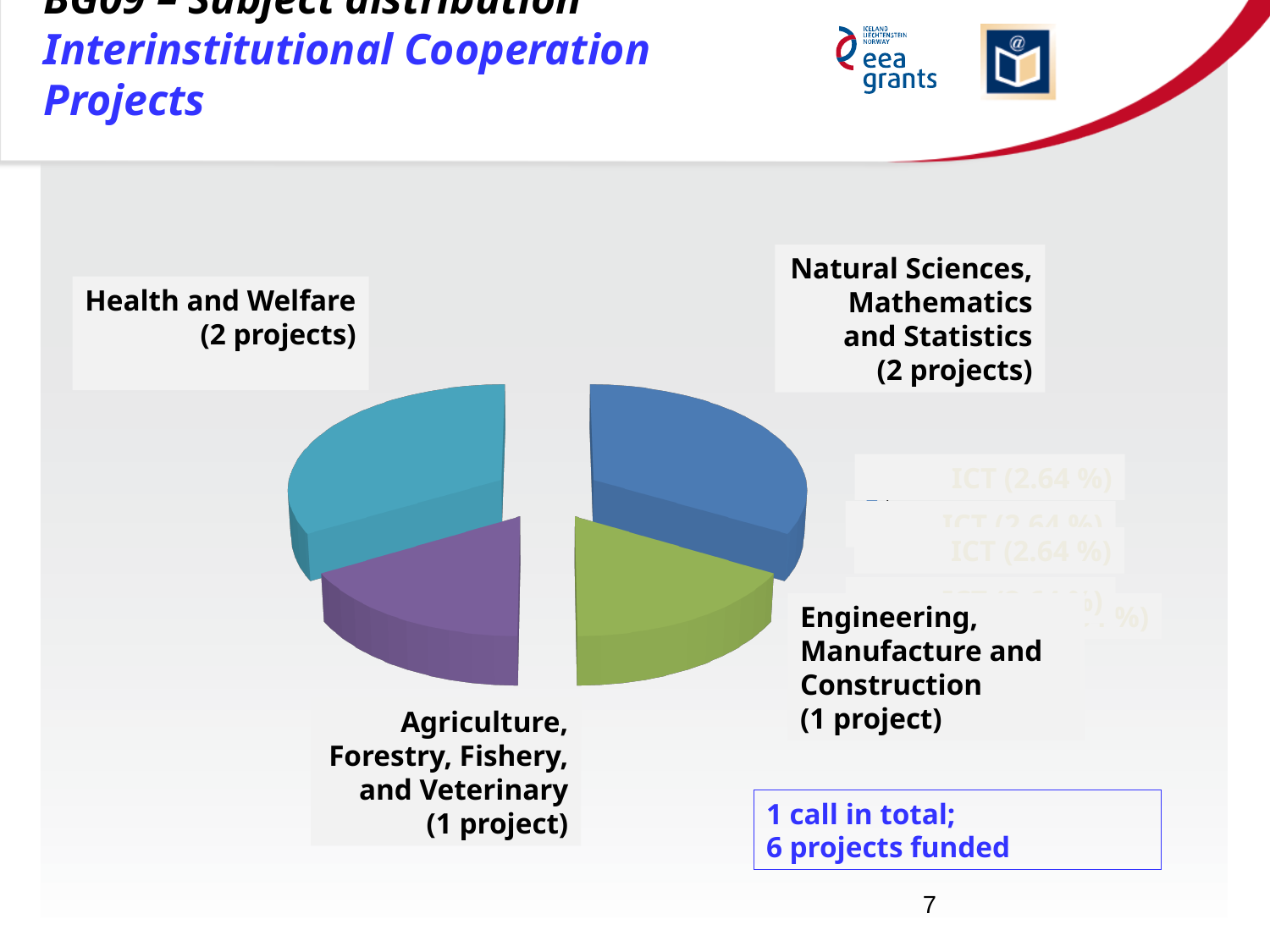
How many projects does the Engineering, Manufacture and Construction slice represent? 1 project What kind of chart is shown on the slide? Pie chart Which has more projects: Natural Sciences, Mathematics and Statistics or Agriculture, Forestry, Fishery, and Veterinary? Natural Sciences, Mathematics and Statistics What colour is the Engineering, Manufacture and Construction slice? Green How many categories (slices) does the pie chart show? 4 How many projects does the Health and Welfare slice represent? 2 projects What is the difference in the number of projects between Health and Welfare and Agriculture, Forestry, Fishery, and Veterinary? 1 project How many calls in total are mentioned on the slide? 1 call Which has more projects: Health and Welfare or Engineering, Manufacture and Construction? Health and Welfare How many projects are in the Agriculture, Forestry, Fishery, and Veterinary category? 1 project What is the total number of projects funded according to the slide? 6 projects How many projects are in the Natural Sciences, Mathematics and Statistics category? 2 projects